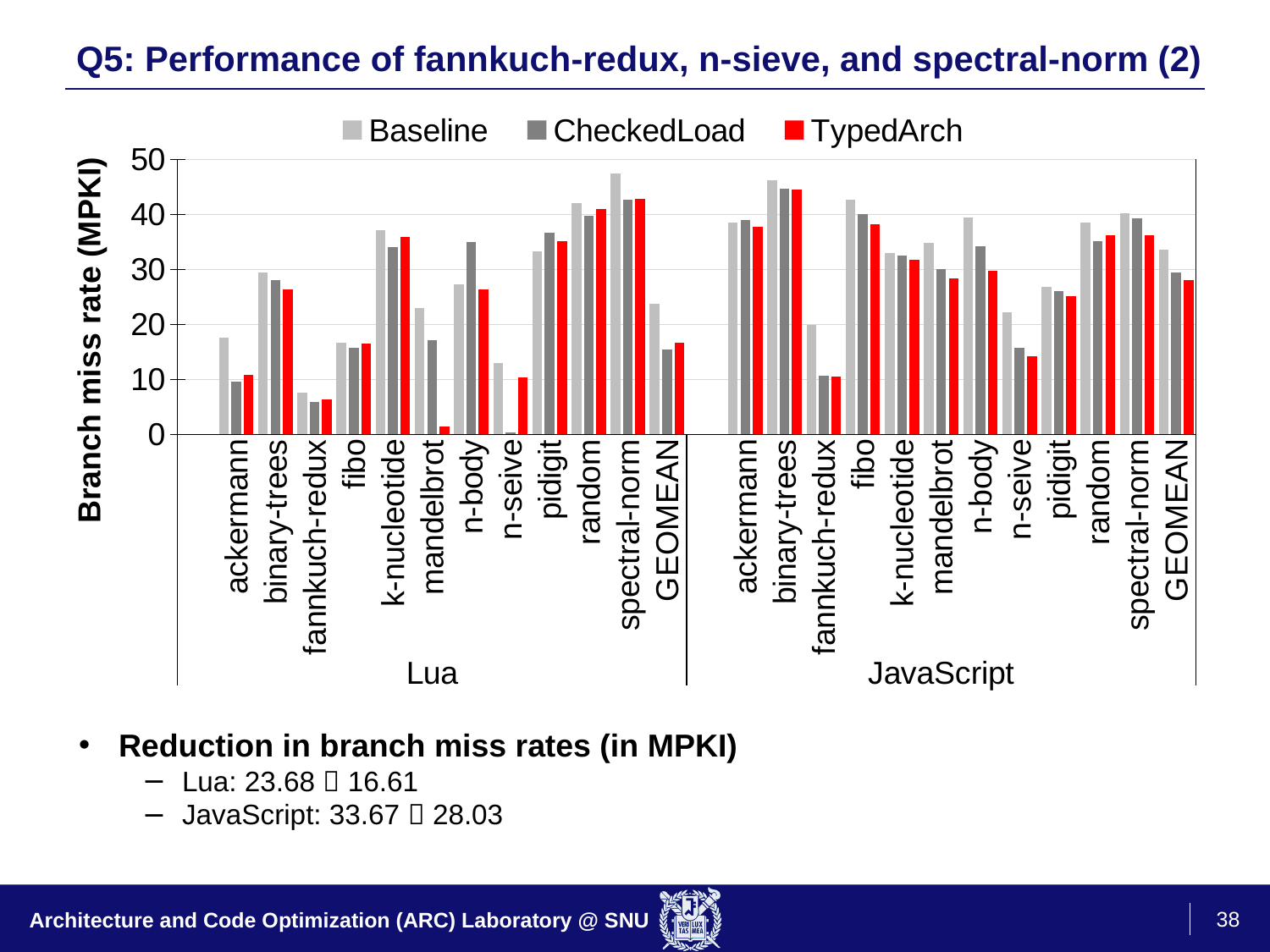
Is the Baseline value for spectral-norm in the Lua group greater or less than 40? greater Which series is drawn in red in the chart? TypedArch According to the slide, what is the GEOMEAN TypedArch branch miss rate for JavaScript? 28.03 Is the TypedArch value for fannkuch-redux in the JavaScript group greater or less than 20? less How many categories are plotted in the Lua group of the chart? 12 According to the slide, what is the GEOMEAN Baseline branch miss rate for Lua? 23.68 What kind of chart is shown on the slide? bar chart Which category in the Lua group has the highest Baseline branch miss rate? spectral-norm For mandelbrot in the Lua group, which is larger: the Baseline value or the TypedArch value? Baseline How many series does the chart legend list? 3 What is the label of the y axis of the chart? Branch miss rate (MPKI) Which category in the JavaScript group has the highest Baseline branch miss rate? binary-trees